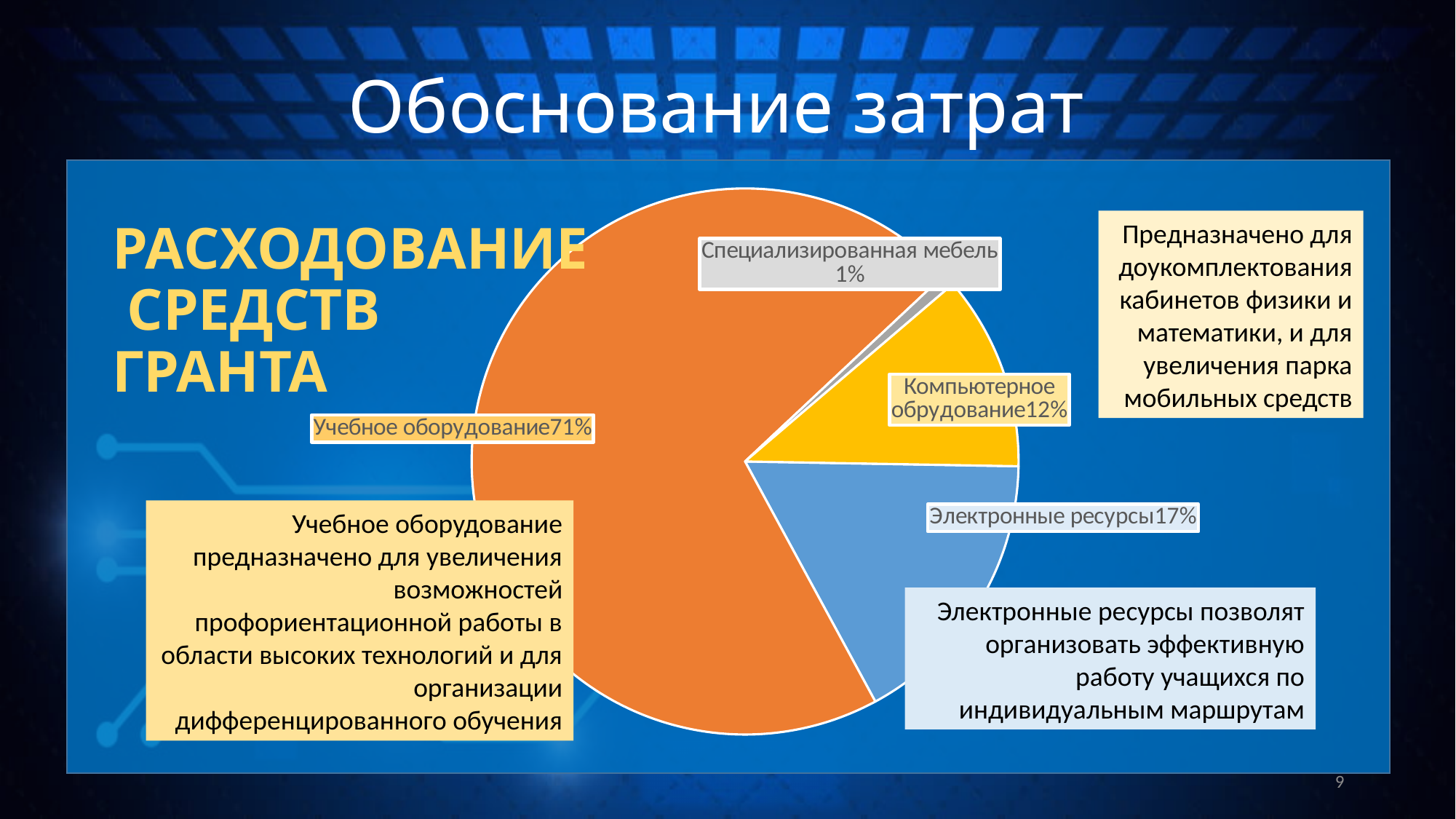
What share of the pie does Специализированная мебель take? 1% Which category has the largest slice of the pie? Учебное оборудование What kind of chart is shown on the slide? pie chart How many slices does the pie chart have? 4 Which is larger: the share for Электронные ресурсы or the share for Компьютерное оборудование? Электронные ресурсы What colour is the slice for Учебное оборудование? orange Which category has the smallest slice of the pie? Специализированная мебель What share of the pie does Учебное оборудование take? 71% What share of the pie does Электронные ресурсы take? 17% What is the difference in percentage points between Компьютерное оборудование and Специализированная мебель? 11 What is the difference in percentage points between Учебное оборудование and Электронные ресурсы? 54